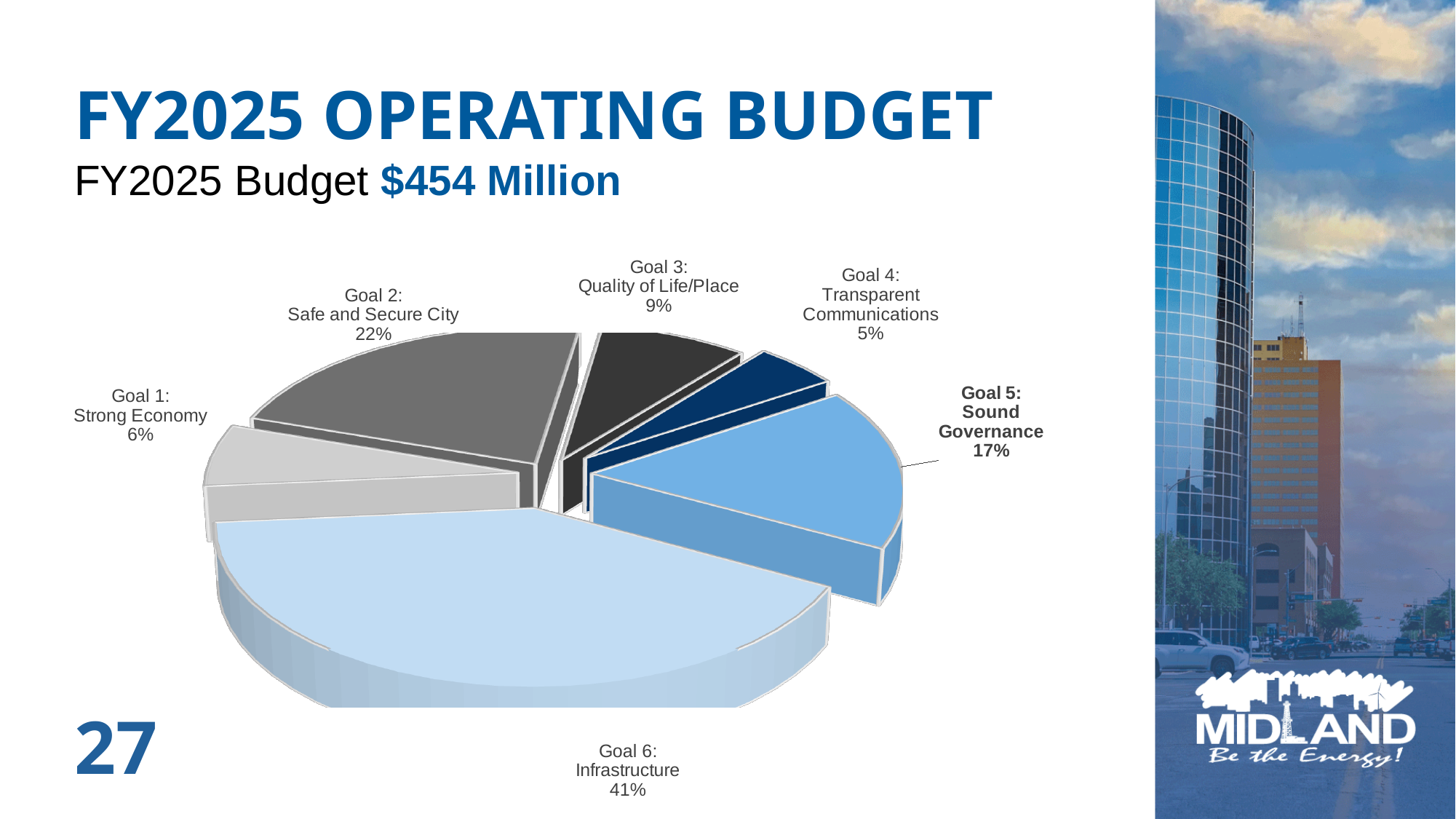
How many goals (slices) are shown in the pie chart? 6 What share of the FY2025 operating budget goes to Goal 6: Infrastructure? 41% What total FY2025 budget amount is stated on the slide? $454 Million How many percentage points larger is Goal 6: Infrastructure than Goal 2: Safe and Secure City? 19 What percentage is shown for Goal 4: Transparent Communications? 5% Which is larger, the share for Goal 1: Strong Economy or Goal 3: Quality of Life/Place? Goal 3: Quality of Life/Place What kind of chart is shown on the slide? Pie chart What is the combined share of Goal 1: Strong Economy and Goal 4: Transparent Communications? 11% Which goal has the smallest share of the FY2025 operating budget? Goal 4: Transparent Communications What percentage is shown for Goal 5: Sound Governance? 17% What percentage of the budget is allocated to Goal 2: Safe and Secure City? 22% Which goal has the largest share of the FY2025 operating budget? Goal 6: Infrastructure